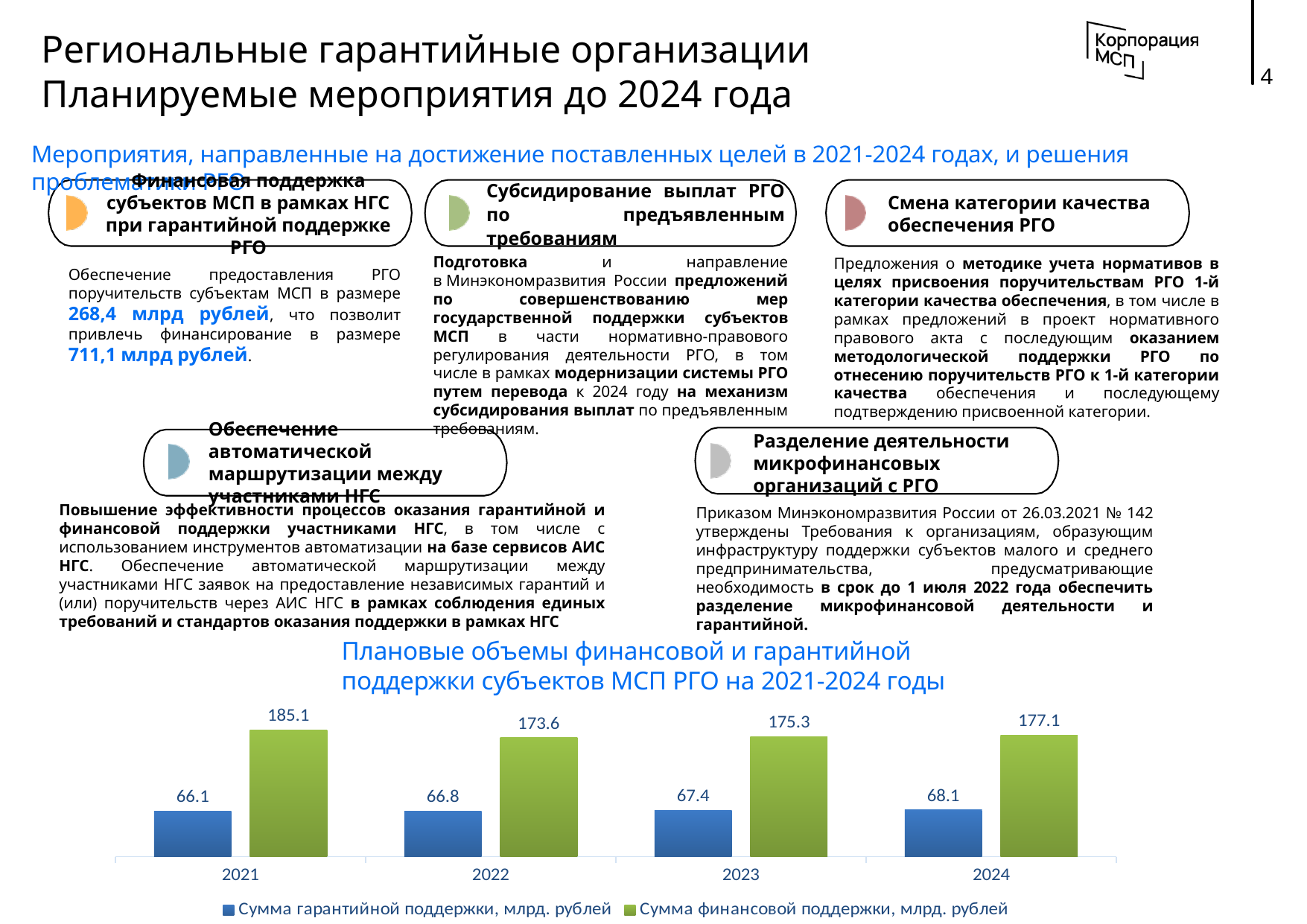
In which year is 'Сумма финансовой поддержки, млрд. рублей' highest? 2021 Which is larger in 2023: 'Сумма гарантийной поддержки' or 'Сумма финансовой поддержки'? Сумма финансовой поддержки What type of chart is shown at the bottom of the slide? Bar chart How many years are shown on the x axis of the chart? 4 What is the value of 'Сумма финансовой поддержки, млрд. рублей' for 2024? 177.1 What is the difference between 'Сумма финансовой поддержки' and 'Сумма гарантийной поддержки' in 2024? 109 What is the value of 'Сумма гарантийной поддержки, млрд. рублей' for 2023? 67.4 How many series does the chart legend list? 2 In which year is 'Сумма гарантийной поддержки, млрд. рублей' lowest? 2021 What is the value of 'Сумма финансовой поддержки, млрд. рублей' for 2022? 173.6 Does 'Сумма гарантийной поддержки, млрд. рублей' rise or fall from 2021 to 2024? Rise What is the value of 'Сумма гарантийной поддержки, млрд. рублей' for 2021? 66.1